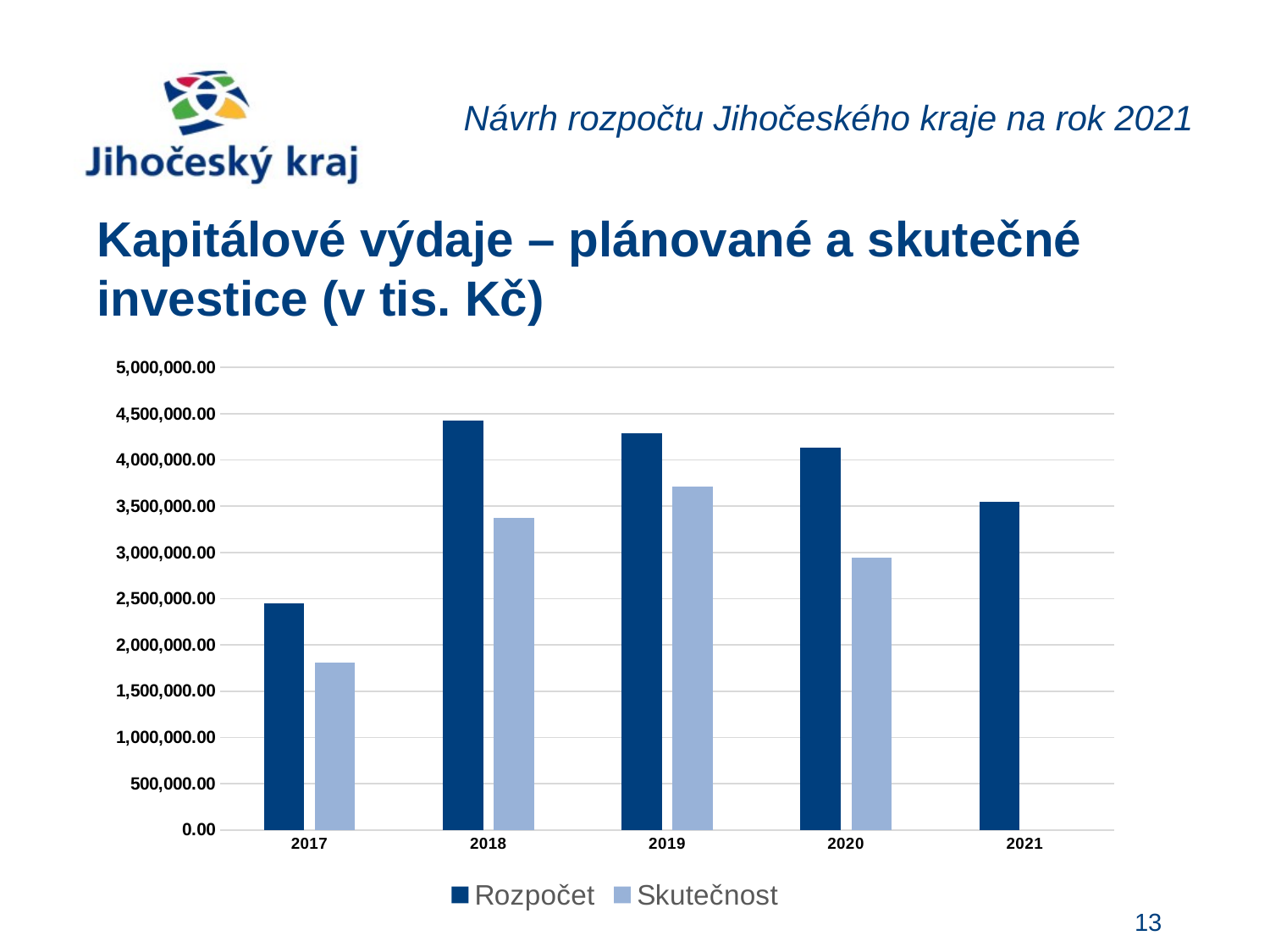
Is the Rozpočet value for 2018 greater or less than 4,000,000.00? greater Which year has the highest Rozpočet value? 2018 Which year has the highest Skutečnost value? 2019 Which year has no Skutečnost bar? 2021 Which year has the lowest Skutečnost value? 2017 Is the Skutečnost value for 2020 greater or less than 3,000,000.00? less How many years are shown on the x axis? 5 What kind of chart is shown on the slide? bar chart How many series does the legend list? 2 Which is larger in 2019, Rozpočet or Skutečnost? Rozpočet Which year has the lowest Rozpočet value? 2017 Is the Skutečnost value for 2017 greater or less than 2,000,000.00? less